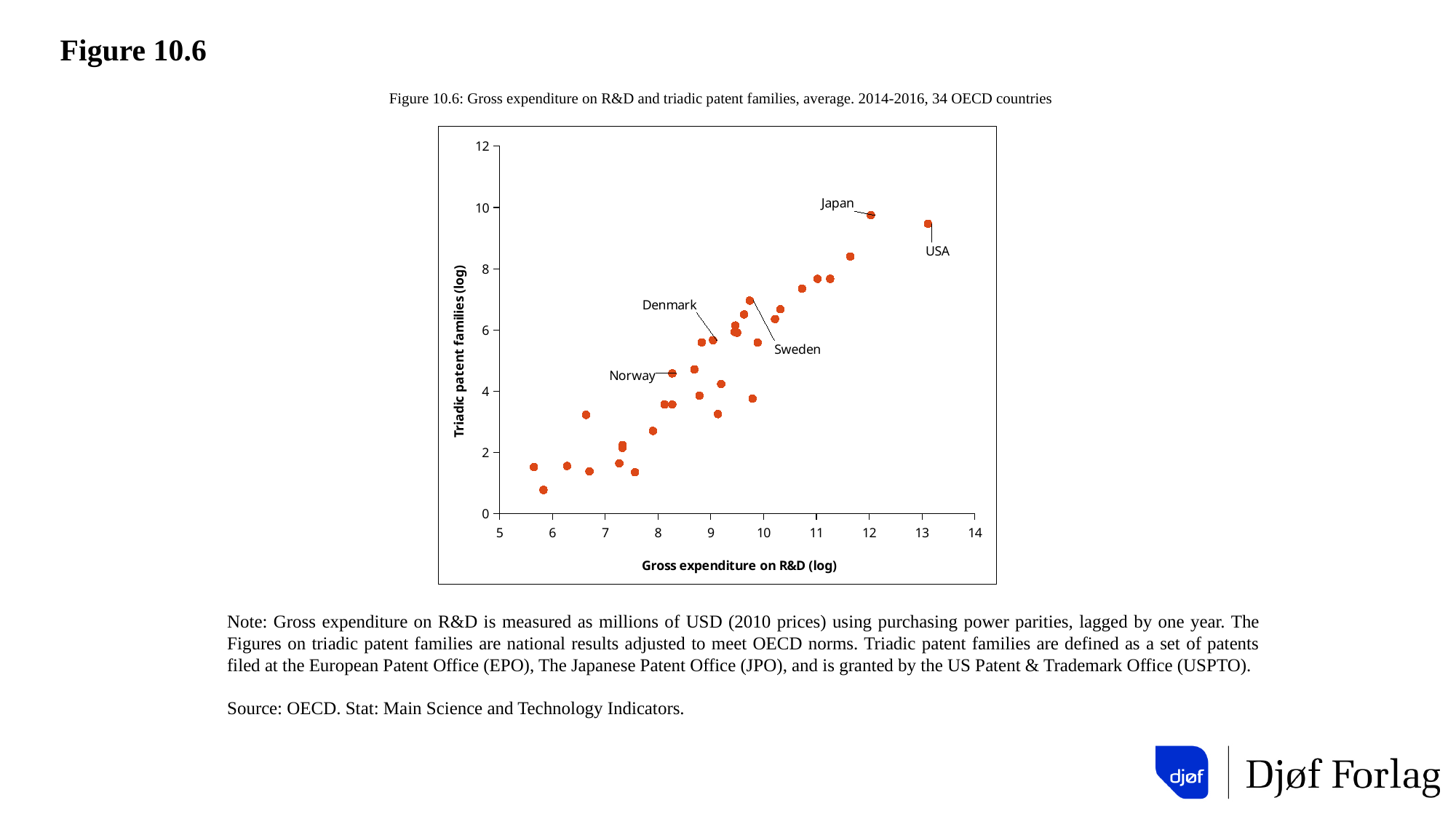
Is the triadic patent families (log) value for Japan greater or less than 8? greater Which has a higher triadic patent families (log) value, Japan or Norway? Japan Which labelled country has the lowest triadic patent families (log) value? Norway Is the gross expenditure on R&D (log) value for USA greater or less than 12? greater What is the label of the x axis? Gross expenditure on R&D (log) According to the chart title, how many OECD countries are included? 34 What kind of chart is shown on the slide? Scatter plot Do the values of triadic patent families generally rise or fall as gross expenditure on R&D increases? Rise What is the label of the y axis? Triadic patent families (log) Which labelled country has the highest gross expenditure on R&D (log)? USA Is the triadic patent families (log) value for Norway greater or less than 6? less Which has a higher gross expenditure on R&D (log) value, USA or Denmark? USA